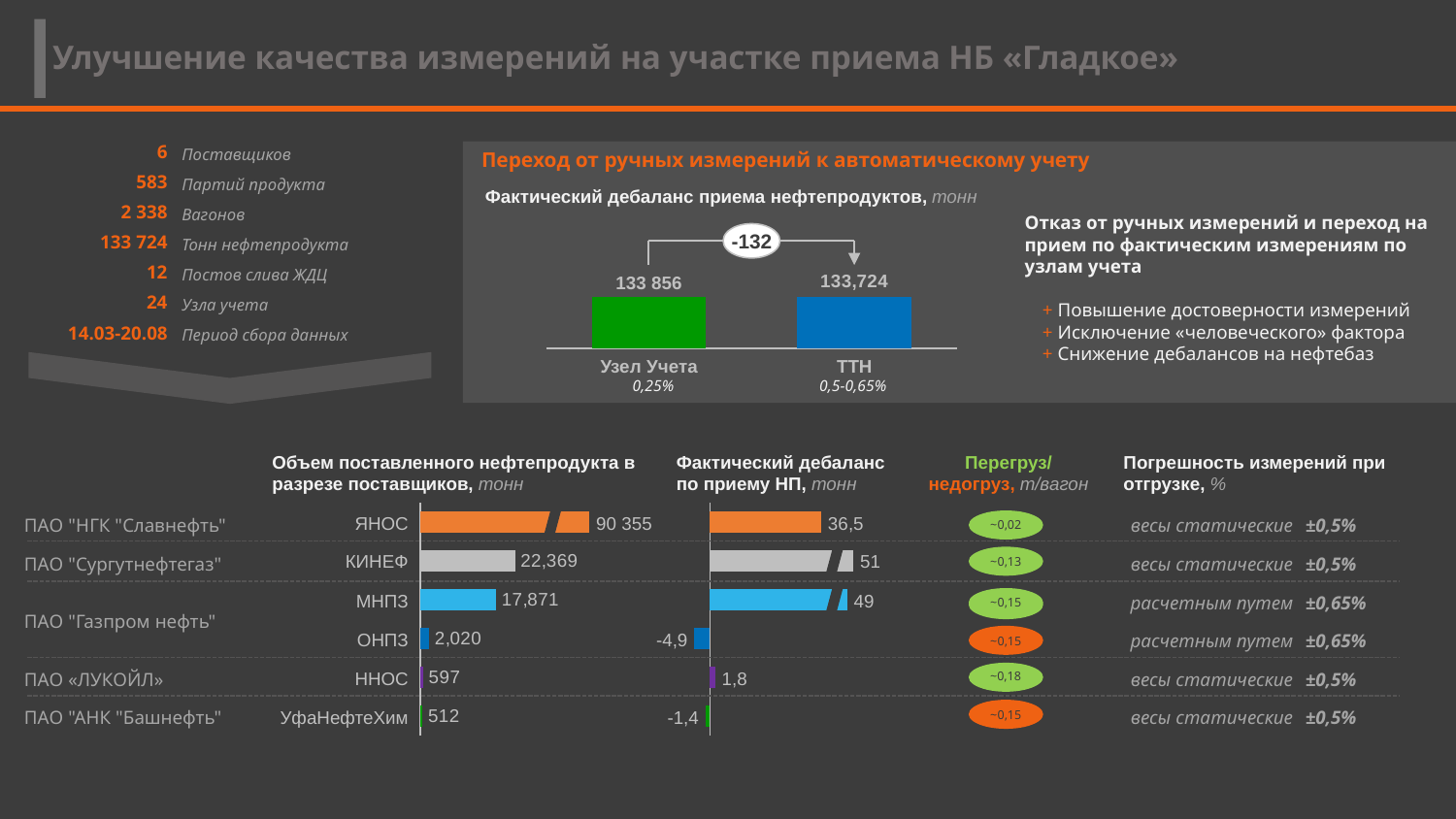
In the chart "Фактический дебаланс приема нефтепродуктов, тонн", what difference between the two bars is shown in the callout? -132 In the chart "Фактический дебаланс по приему НП, тонн", what is the value for УфаНефтеХим? -1,4 In the chart "Фактический дебаланс приема нефтепродуктов, тонн", what is the value for Узел Учета? 133 856 What type of chart is "Объем поставленного нефтепродукта в разрезе поставщиков, тонн"? Bar chart In the chart "Фактический дебаланс приема нефтепродуктов, тонн", what is the value for ТТН? 133,724 In the chart "Объем поставленного нефтепродукта в разрезе поставщиков, тонн", how many categories are plotted? 6 In the chart "Объем поставленного нефтепродукта в разрезе поставщиков, тонн", what is the value for ЯНОС? 90 355 In the chart "Объем поставленного нефтепродукта в разрезе поставщиков, тонн", what is the value for КИНЕФ? 22,369 In the chart "Фактический дебаланс приема нефтепродуктов, тонн", which bar is higher, Узел Учета or ТТН? Узел Учета In the chart "Фактический дебаланс по приему НП, тонн", which category has the highest value? КИНЕФ In the chart "Фактический дебаланс по приему НП, тонн", what is the value for ОНПЗ? -4,9 In the chart "Объем поставленного нефтепродукта в разрезе поставщиков, тонн", which category has the lowest value? УфаНефтеХим